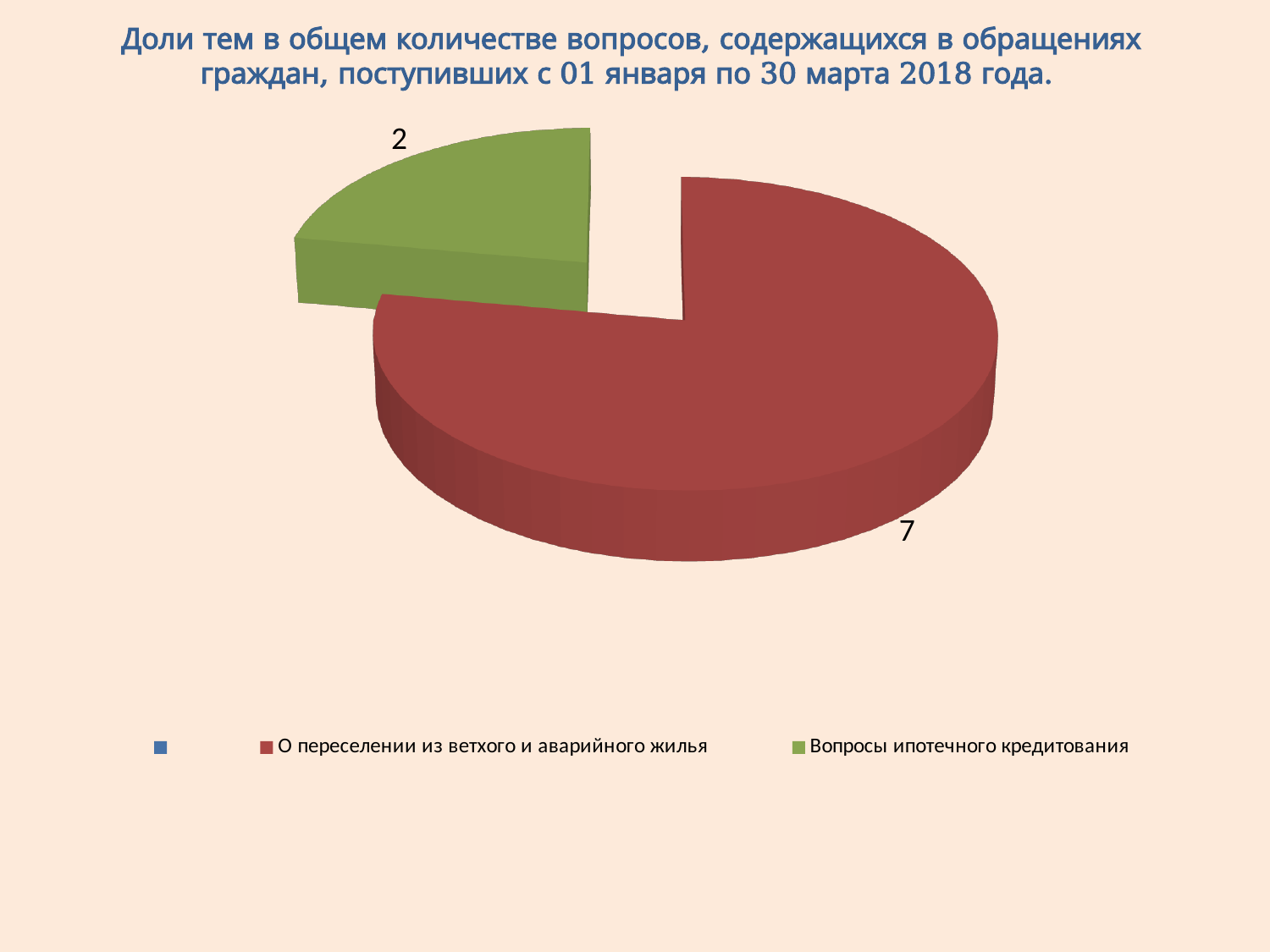
What period does the chart title say the citizens' appeals were received in? с 01 января по 30 марта 2018 года Which category has the largest slice of the pie? О переселении из ветхого и аварийного жилья Which is larger: the value for 'Вопросы ипотечного кредитования' or the value for 'О переселении из ветхого и аварийного жилья'? О переселении из ветхого и аварийного жилья What is the total of the values shown on the pie chart? 9 How many slices with data labels does the pie chart show? 2 What colour is the slice for 'Вопросы ипотечного кредитования'? Green What type of chart is shown on the slide? Pie chart What is the difference between the values for 'О переселении из ветхого и аварийного жилья' and 'Вопросы ипотечного кредитования'? 5 Which category has the smallest slice of the pie? Вопросы ипотечного кредитования What value is shown for the slice 'О переселении из ветхого и аварийного жилья'? 7 What value is shown for the slice 'Вопросы ипотечного кредитования'? 2